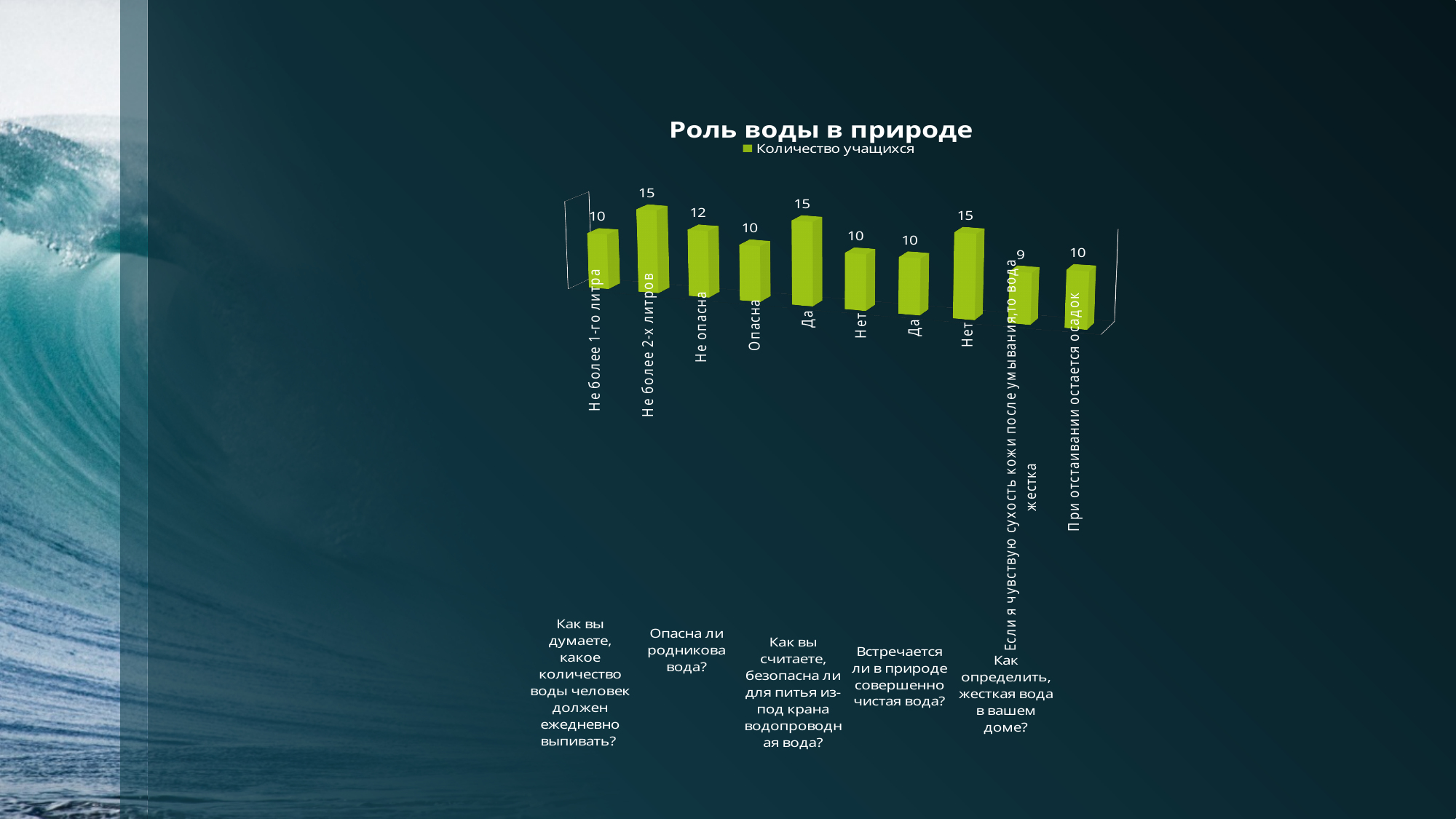
How many series does the legend list? 1 What type of chart is shown on the slide? bar chart What is the value for "Не более 2-х литров"? 15 What is the value for "При отстаивании остается осадок"? 10 Which is larger: the value for "Не опасна" or the value for "Опасна"? Не опасна What is the value for "Если я чувствую сухость кожи после умывания, то вода жестка"? 9 Which category has the lowest value? Если я чувствую сухость кожи после умывания, то вода жестка What is the difference between the values for "Не более 2-х литров" and "Не более 1-го литра"? 5 What is the title of the chart? Роль воды в природе What is the name of the series shown in the legend? Количество учащихся How many bars are plotted in the chart? 10 What is the value for "Не опасна"? 12